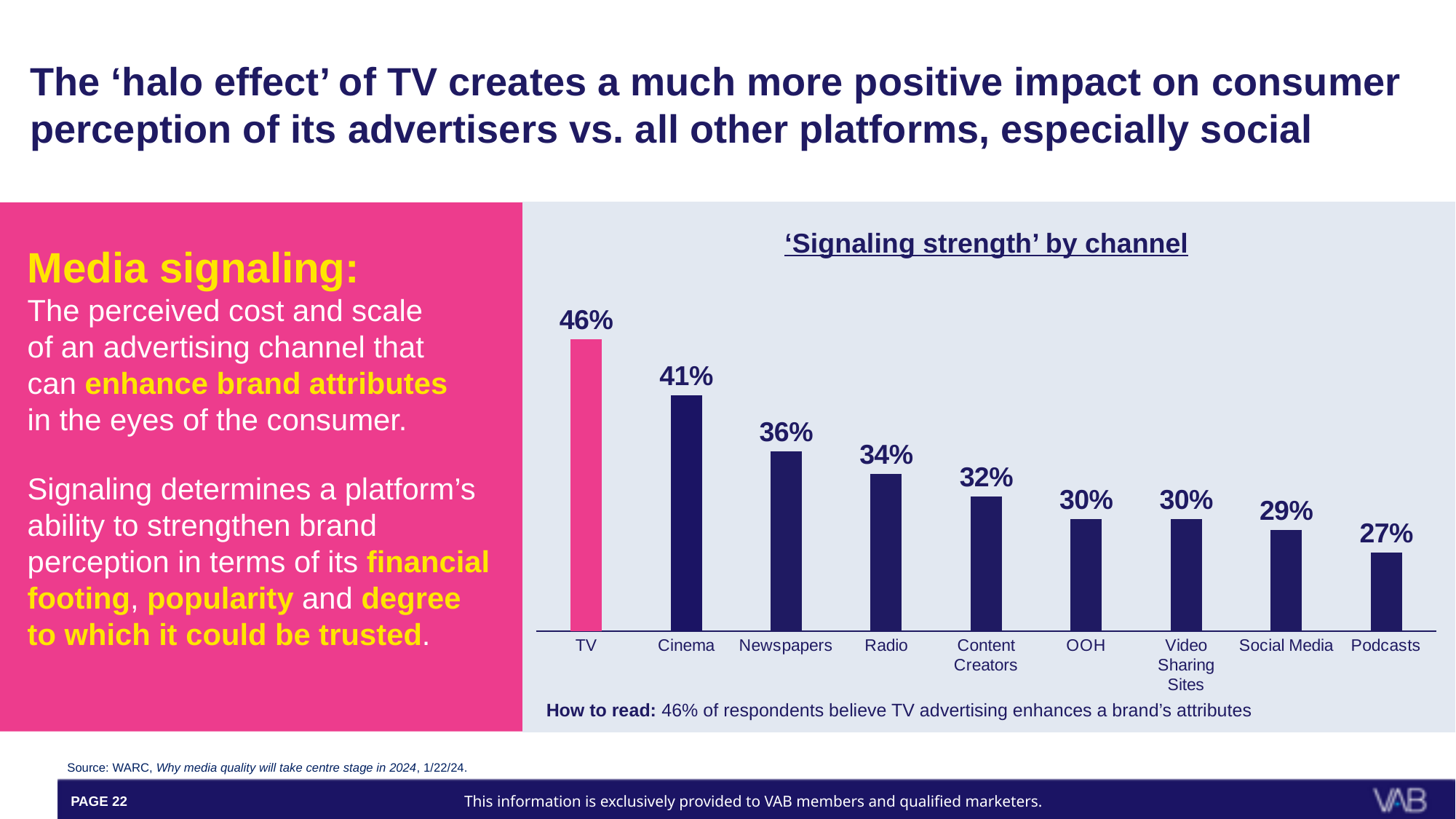
What is the difference in signaling strength between TV and Cinema? 5% Which has a higher signaling strength, Cinema or Content Creators? Cinema Which channel has the highest signaling strength? TV Do the values rise or fall moving from left to right across the channels? Fall What is the difference in signaling strength between Radio and Podcasts? 7% What is the signaling strength value for Social Media? 29% Which channel has the lowest signaling strength? Podcasts What is the title of the chart? 'Signaling strength' by channel How many channels are shown in the chart? 9 What is the signaling strength value for TV? 46% What kind of chart is shown on the slide? Bar chart What is the signaling strength value for Newspapers? 36%